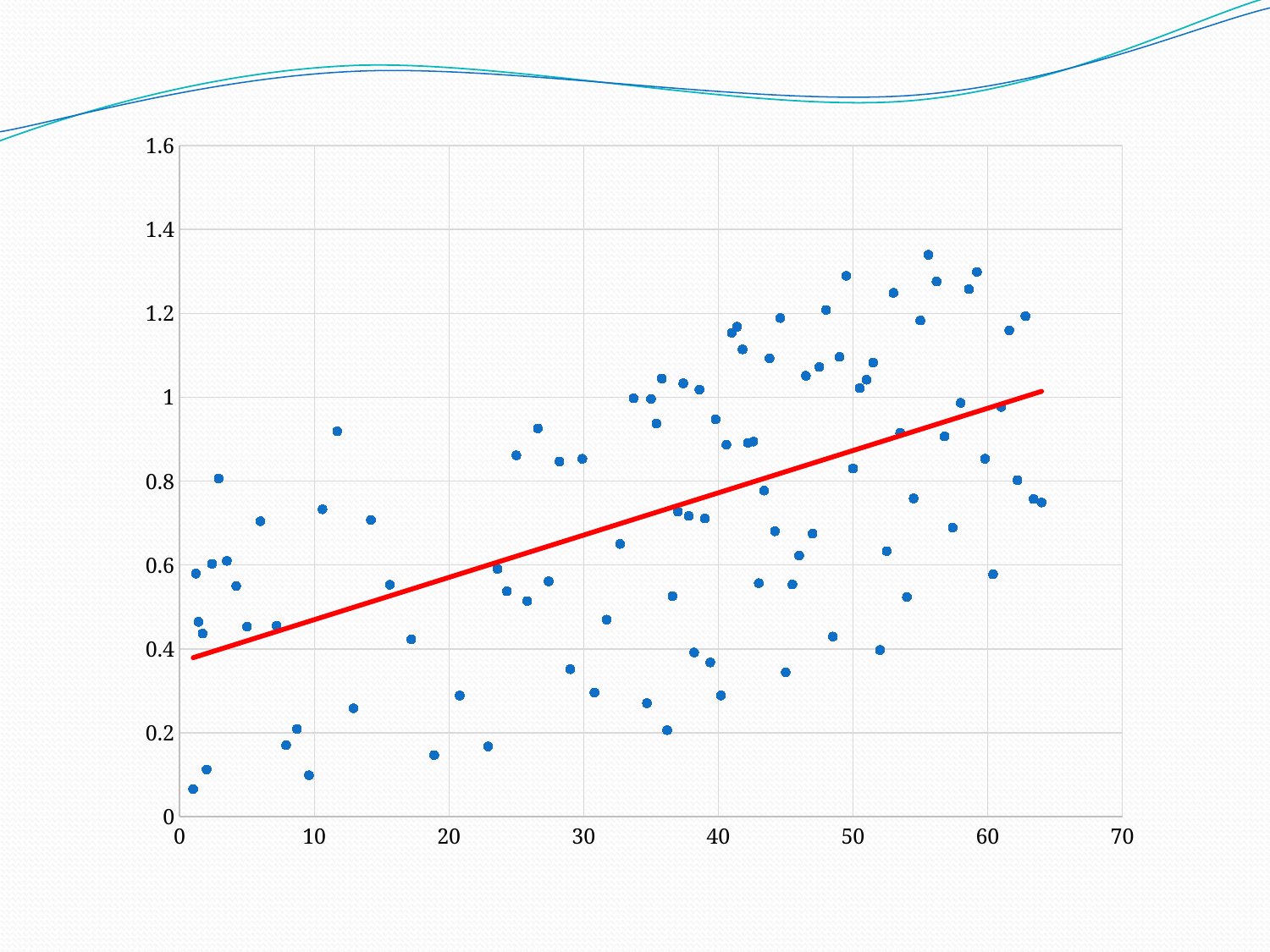
Is the highest plotted point greater or less than 1.2 on the y-axis? greater Is the value of the red line at its left end (near x = 0) greater or less than 0.6? less Does the red line slope upward or downward from left to right? upward Is the lowest plotted point greater or less than 0.2 on the y-axis? less What kind of chart is shown on the slide? scatter chart Do the plotted points generally rise or fall as the x-axis value increases? rise What is the maximum value shown on the x-axis? 70 What is the maximum value shown on the y-axis? 1.6